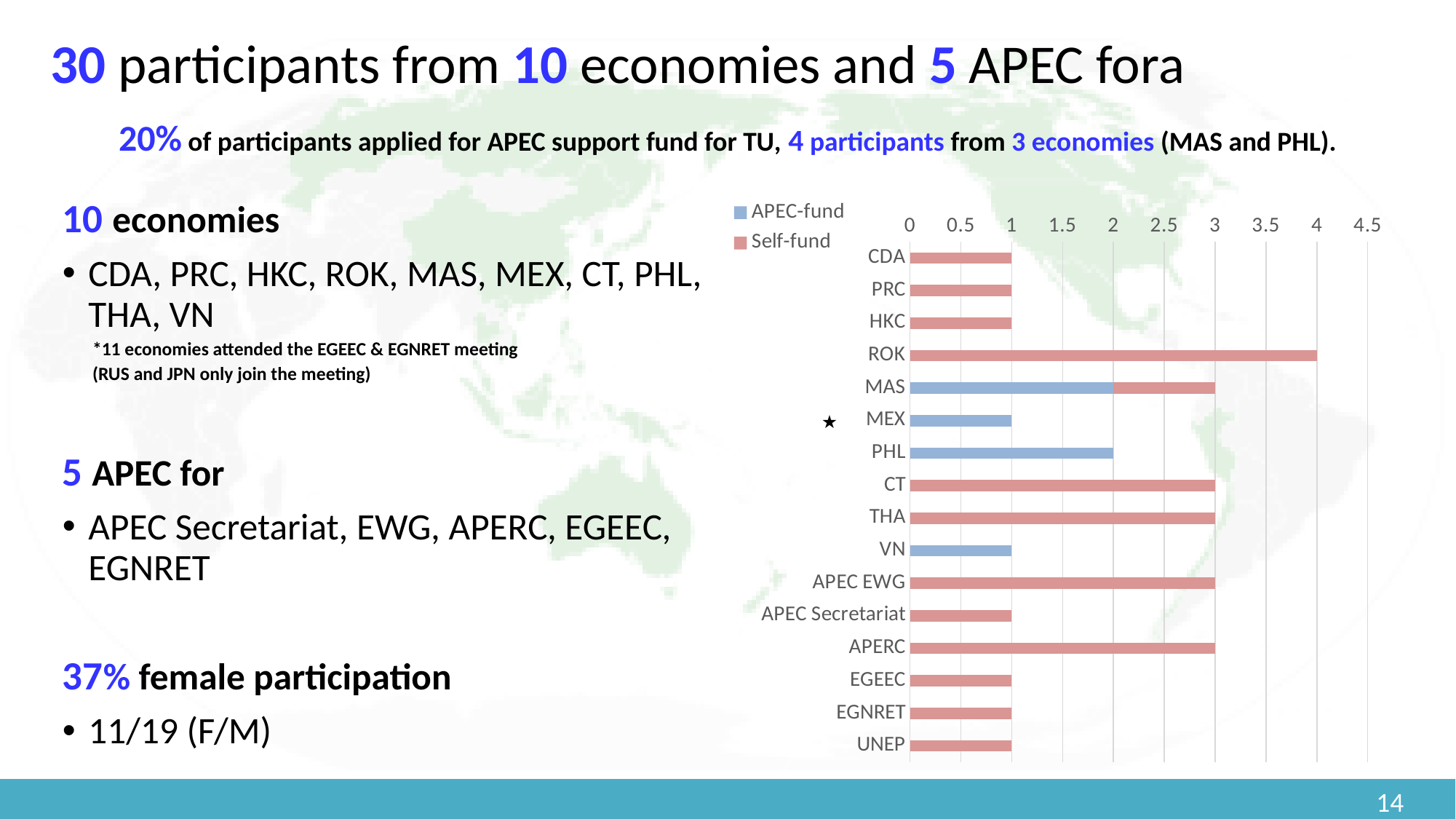
What is the APEC-fund value for MAS? 2 What is the APEC-fund value for PHL? 2 What is the difference between the Self-fund value for ROK and the Self-fund value for CT? 1 Is the value for APERC greater or less than 2? greater How many series does the chart legend list? 2 What is the total length of the stacked bar for MAS? 3 How many categories are plotted on the chart? 16 Which category has the longest bar in the chart? ROK Which is larger, the bar for THA or the bar for VN? THA What kind of chart is shown on the slide? bar chart What is the Self-fund value for ROK? 4 Which series in the legend is shown in blue? APEC-fund